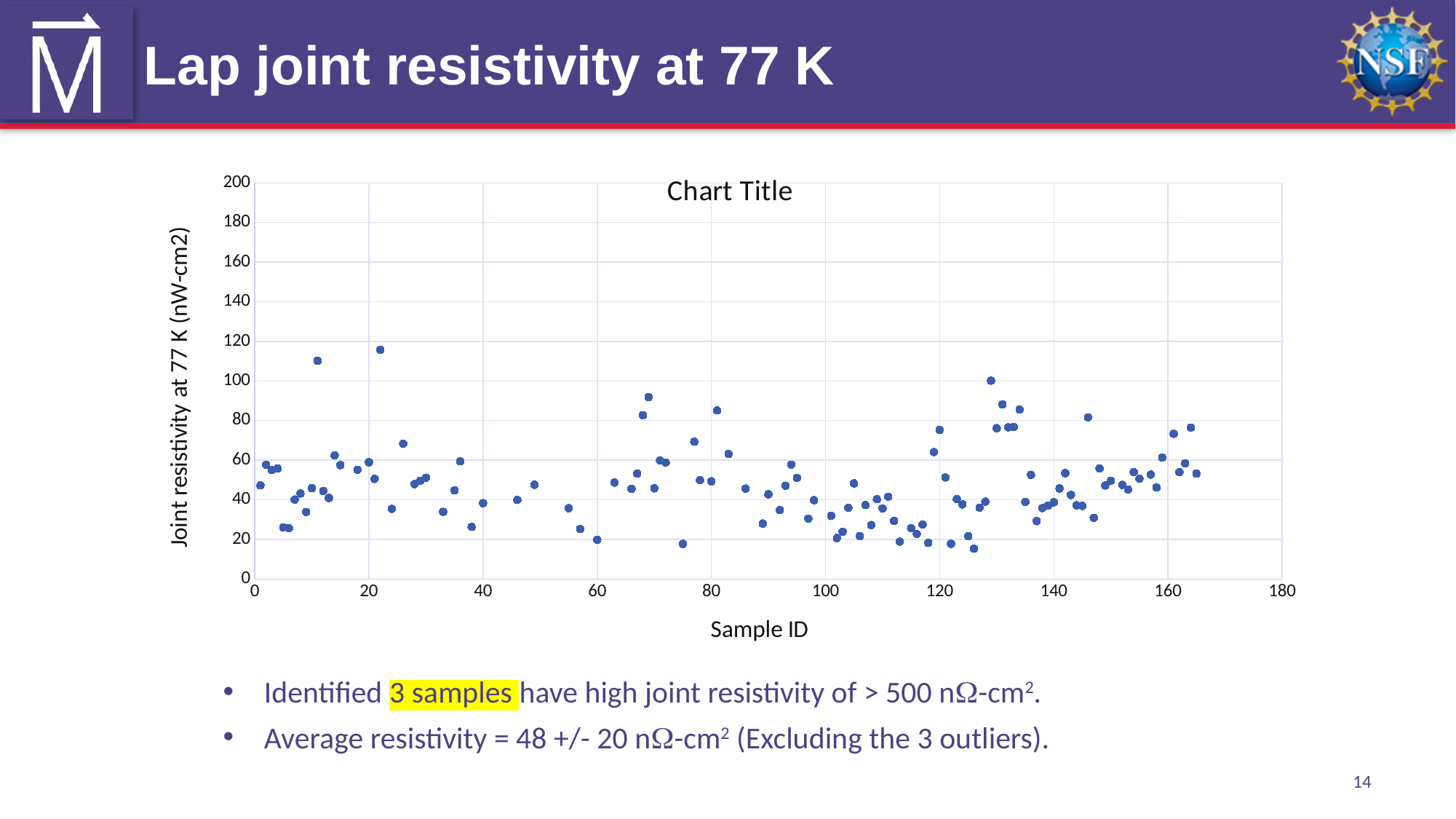
What is the label of the x axis? Sample ID Is the highest plotted value greater or less than 100? greater What is the label of the y axis? Joint resistivity at 77 K (nW-cm2) What is the maximum value shown on the y axis? 200 Is the value for the point at sample ID 60 greater or less than 40? less What is the title shown on the chart? Chart Title What is the maximum value shown on the x axis? 180 What kind of chart is shown on the slide? scatter chart Is the lowest plotted value greater or less than 20? less